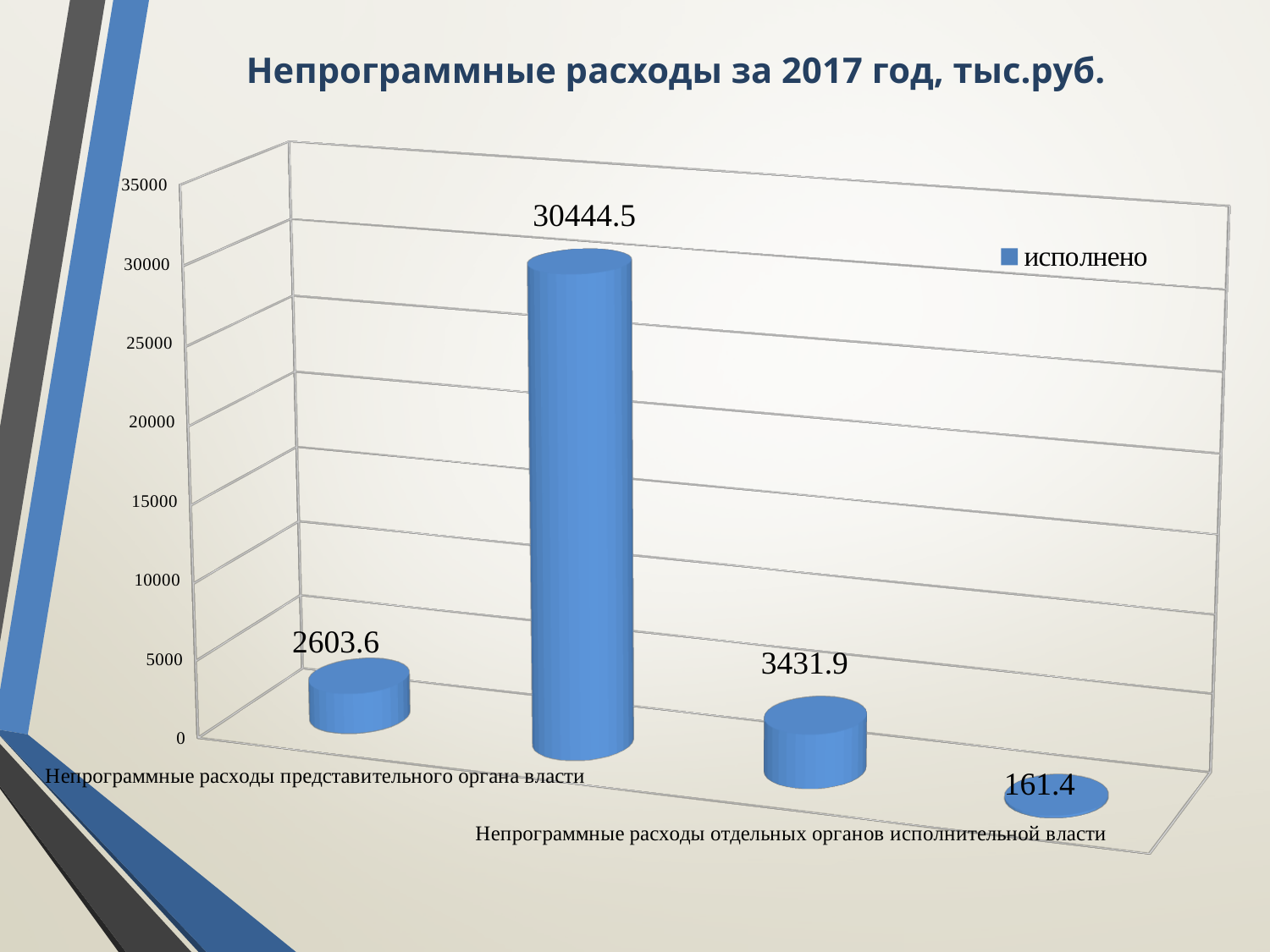
What is the name of the series shown in the legend? исполнено Is the value of the tallest bar greater or less than 30000? greater What is the lowest value shown in the chart? 161.4 What is the title of the chart? Непрограммные расходы за 2017 год, тыс.руб. What is the value for Непрограммные расходы представительного органа власти? 2603.6 How many series does the legend list? 1 Which is larger: the value for Непрограммные расходы представительного органа власти or the value for Непрограммные расходы отдельных органов исполнительной власти? Непрограммные расходы отдельных органов исполнительной власти What is the difference between the value for Непрограммные расходы отдельных органов исполнительной власти and the value for Непрограммные расходы представительного органа власти? 828.3 What is the highest value shown in the chart? 30444.5 What is the value for Непрограммные расходы отдельных органов исполнительной власти? 3431.9 How many bars are plotted in the chart? 4 What kind of chart is shown on the slide? bar chart